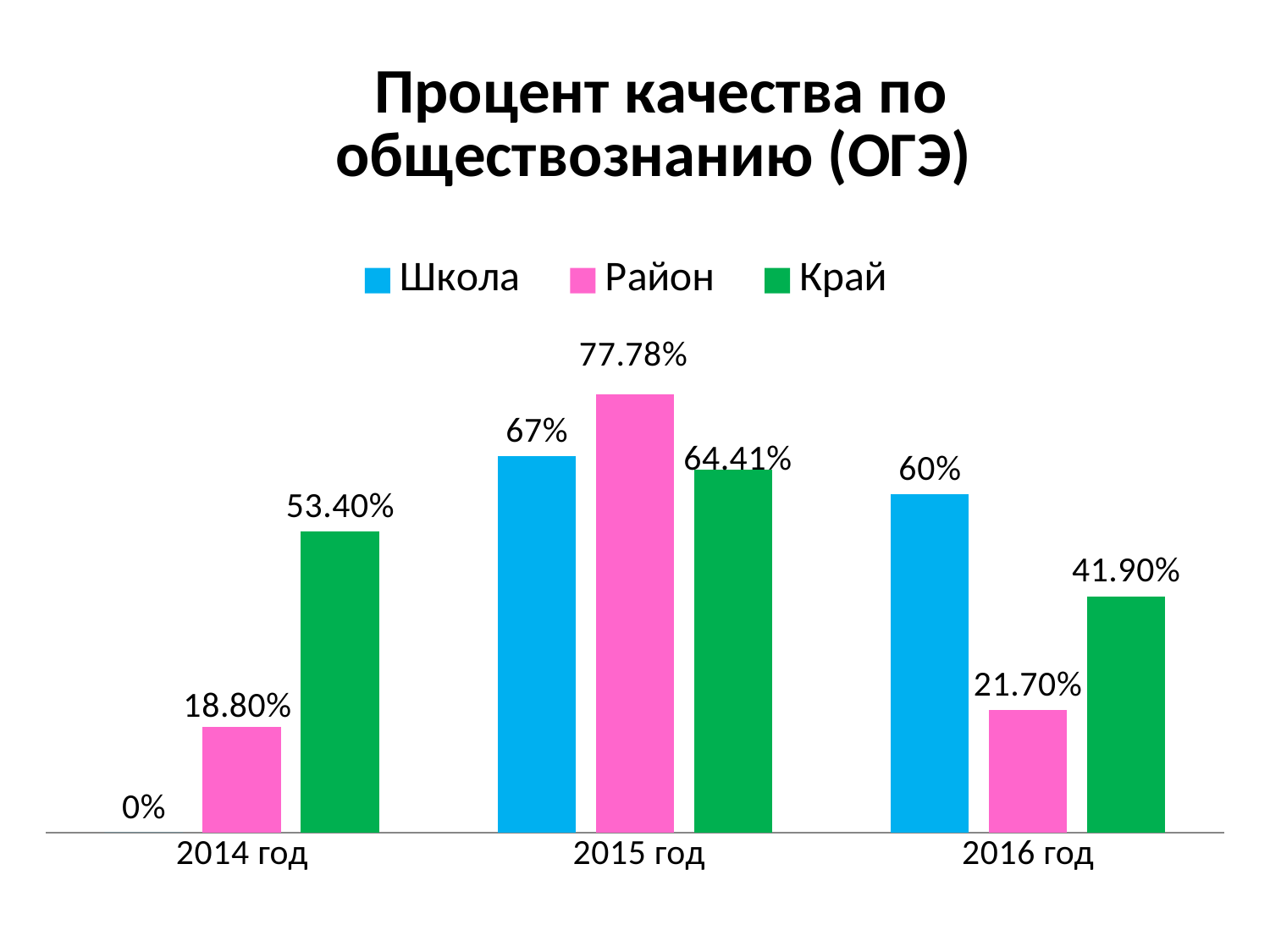
Which is larger in 2016 год, Школа or Край? Школа How many series does the legend list? 3 In which year is the value for Район highest? 2015 год What kind of chart is shown? Bar chart What is the value for Район in 2014 год? 18.80% What is the value for Край in 2016 год? 41.90% In which year is the value for Край lowest? 2016 год What is the value for Школа in 2015 год? 67% What is the title of the chart? Процент качества по обществознанию (ОГЭ) What is the value for Школа in 2014 год? 0% How many years are shown on the x axis? 3 What is the difference between Район and Край in 2015 год? 13.37%